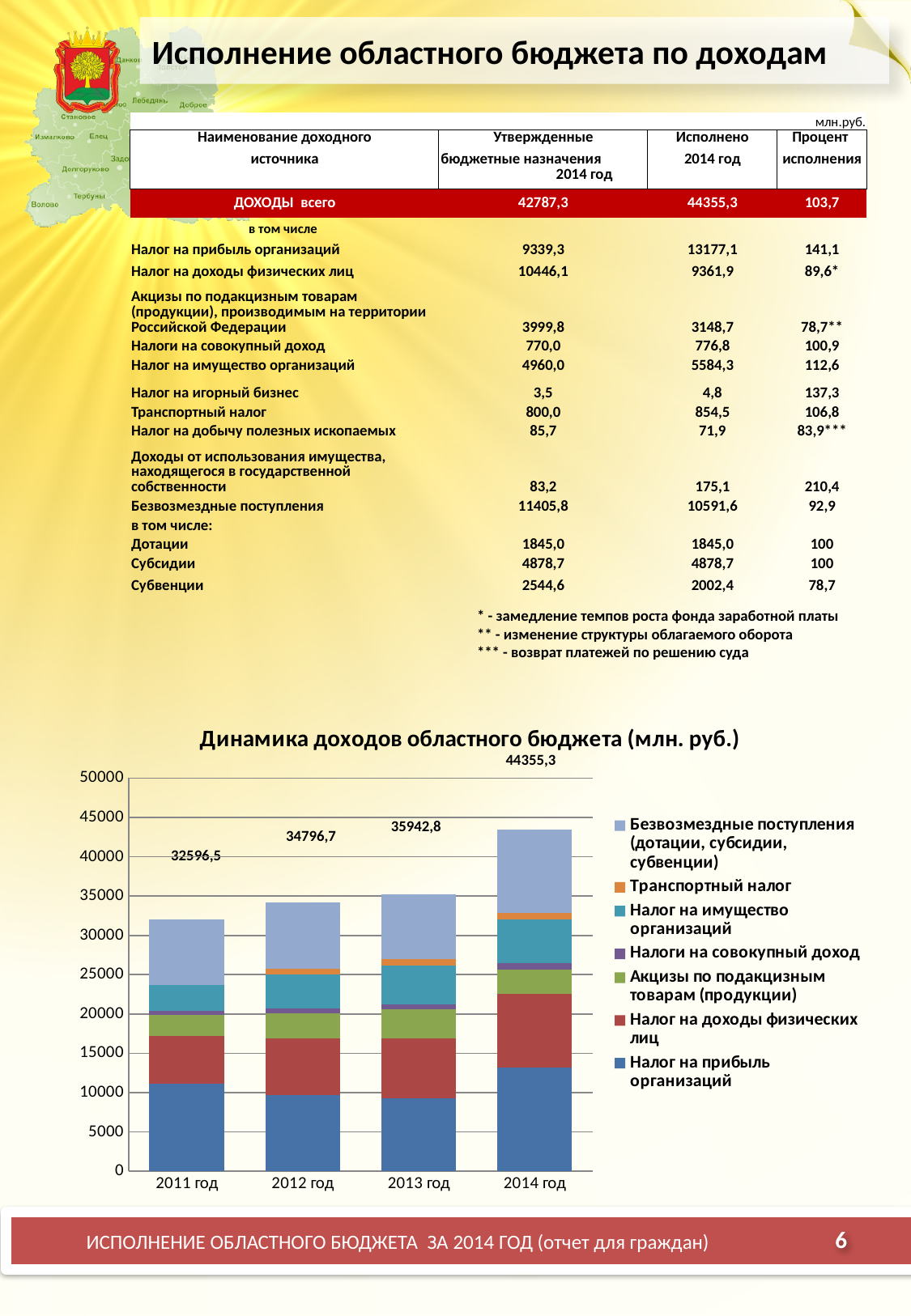
In the chart "Динамика доходов областного бюджета", what is the total labelled for 2013 год? 35942,8 What kind of chart is shown under the title "Динамика доходов областного бюджета (млн. руб.)"? Stacked bar chart In the chart "Динамика доходов областного бюджета", which series is shown at the bottom of each stacked bar? Налог на прибыль организаций In the chart "Динамика доходов областного бюджета", do the total revenues rise or fall from 2011 год to 2014 год? Rise How many years (categories) are shown on the x axis of the chart "Динамика доходов областного бюджета"? 4 How many series does the legend of the chart "Динамика доходов областного бюджета" list? 7 In the chart "Динамика доходов областного бюджета", which year has the lowest total revenue? 2011 год In the chart "Динамика доходов областного бюджета", which year has the highest total revenue? 2014 год In the chart "Динамика доходов областного бюджета", what is the difference between the totals for 2014 год and 2011 год? 11758,8 In the chart "Динамика доходов областного бюджета", what is the difference between the totals for 2013 год and 2012 год? 1146,1 In the chart "Динамика доходов областного бюджета", is the value of "Налог на прибыль организаций" for 2014 год greater or less than 10000? greater In the chart "Динамика доходов областного бюджета", what is the total labelled for 2011 год? 32596,5